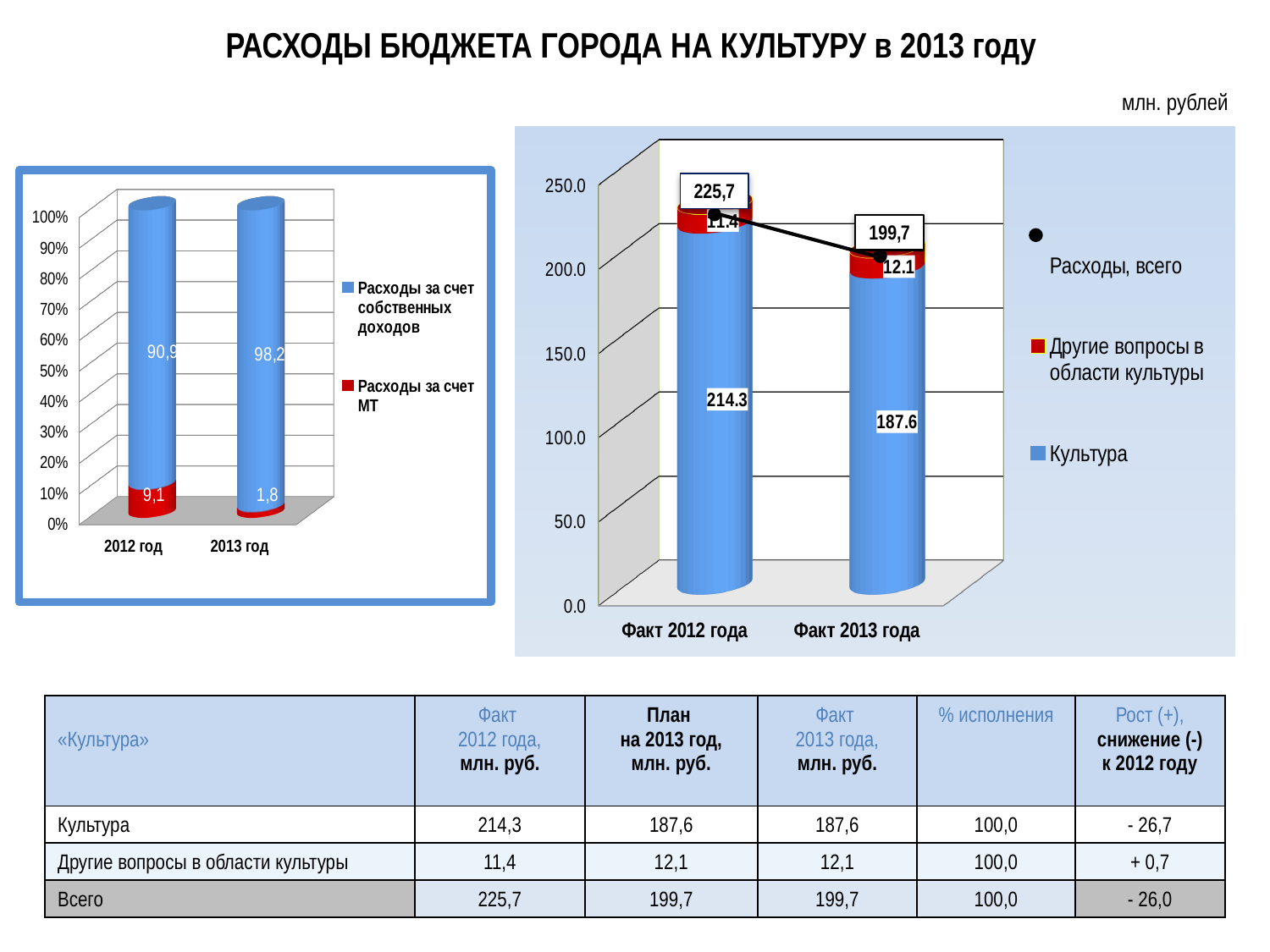
In the left chart, how many series does the legend list? 2 In the right chart, how many series does the legend list? 3 In the right chart, does the total 'Расходы, всего' rise or fall from Факт 2012 года to Факт 2013 года? fall What kind of chart is the right chart? bar chart In the left chart, what is the value of 'Расходы за счет собственных доходов' for 2012 год? 90,9 In the right chart, what is the difference between the 'Культура' values for Факт 2012 года and Факт 2013 года? 26.7 In the right chart, what is the value of 'Культура' for Факт 2012 года? 214.3 In the right chart, what is the value of 'Другие вопросы в области культуры' for Факт 2013 года? 12.1 In the left chart, which year has the larger value for 'Расходы за счет МТ'? 2012 год In the right chart, what is the total 'Расходы, всего' for Факт 2013 года? 199,7 In the right chart, how many categories are shown on the x axis? 2 In the left chart, what is the value of 'Расходы за счет МТ' for 2013 год? 1,8